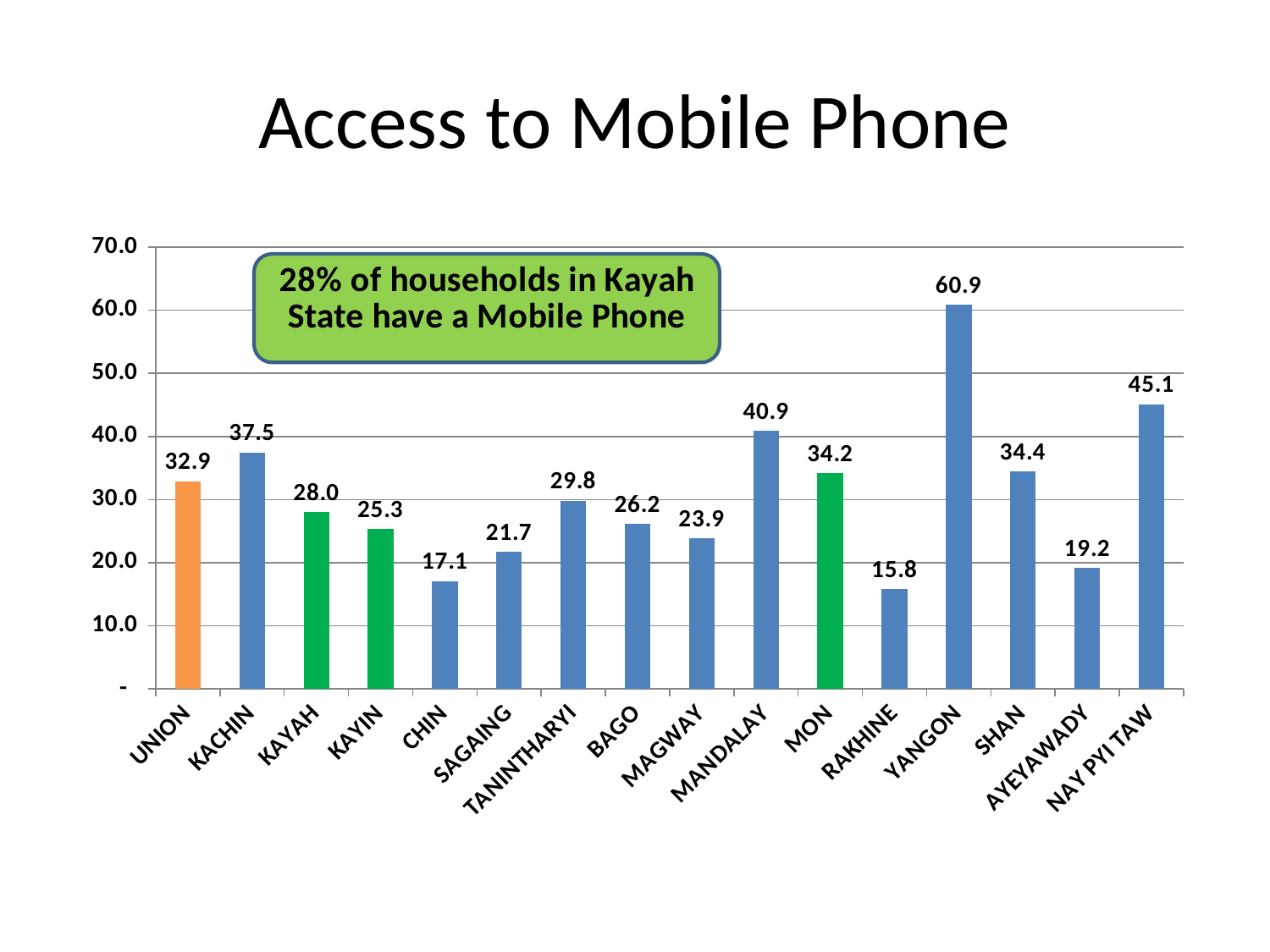
Which category has the lowest value? Rakhine What is the difference between the values for Kachin and Kayah? 9.5 Is the value for Nay Pyi Taw greater or less than 40.0? greater How many categories are shown on the x axis? 16 Which category has the highest value? Yangon What is the title of the slide? Access to Mobile Phone What is the value for Kayah? 28.0 Which is larger, the value for Mandalay or the value for Mon? Mandalay What kind of chart is shown on the slide? bar chart What is the value for Yangon? 60.9 What is the value for Union? 32.9 What is the difference between the values for Yangon and Rakhine? 45.1